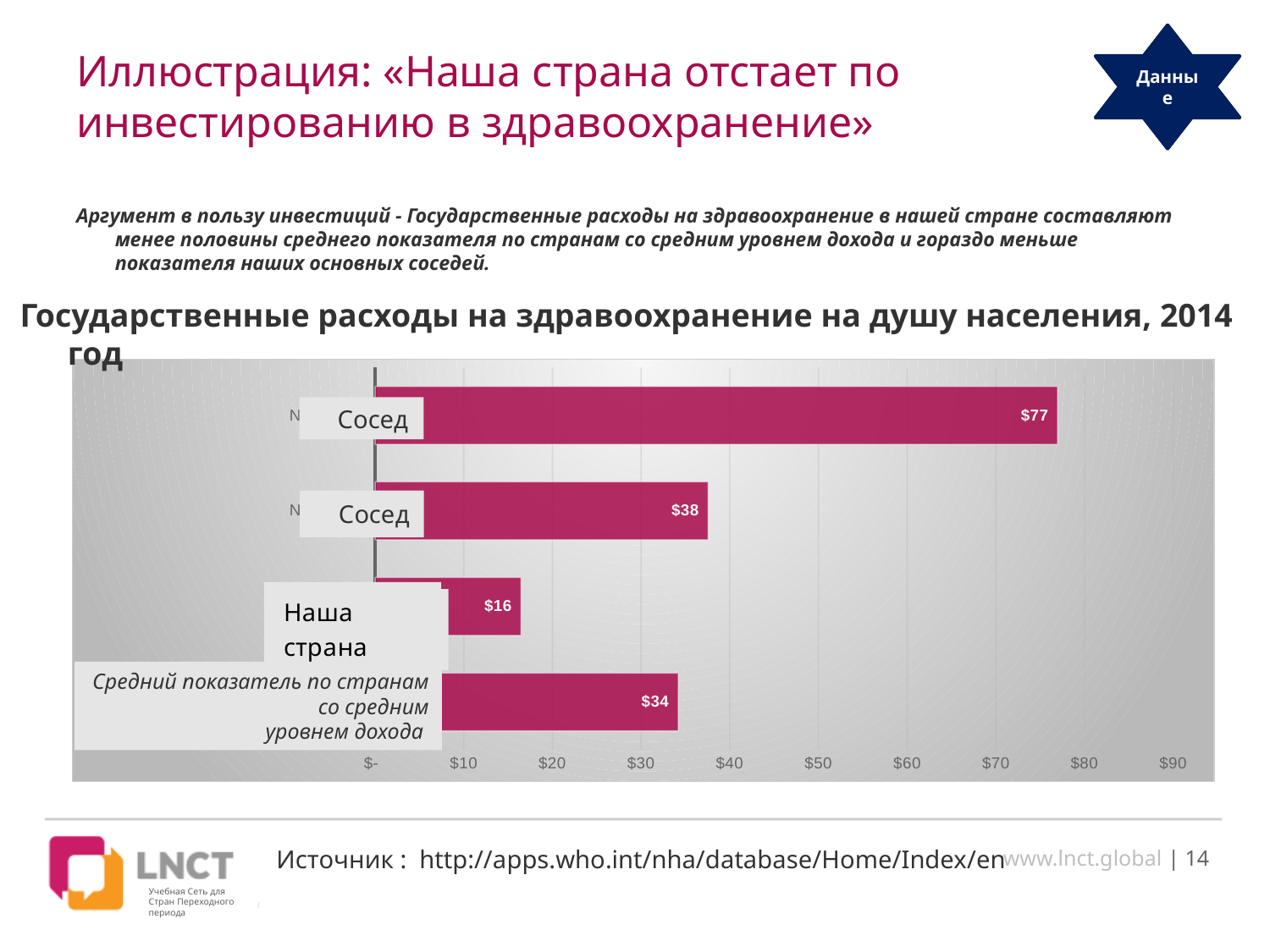
Which category has the lowest value? Наша страна What is the title of the chart? Государственные расходы на здравоохранение на душу населения, 2014 год What is the value of the topmost bar (the first "Сосед")? $77 What type of chart is shown on the slide? bar chart What is the value for "Средний показатель по странам со средним уровнем дохода"? $34 How many bars are plotted in the chart? 4 What is the difference between the value for "Средний показатель по странам со средним уровнем дохода" and the value for "Наша страна"? $18 Which is larger: the value for "Наша страна" or the value for "Средний показатель по странам со средним уровнем дохода"? Средний показатель по странам со средним уровнем дохода What is the highest value shown in the chart? $77 What is the value for "Наша страна"? $16 What is the difference between the topmost bar ($77) and the second bar ($38)? $39 What is the value of the second bar from the top (the second "Сосед")? $38